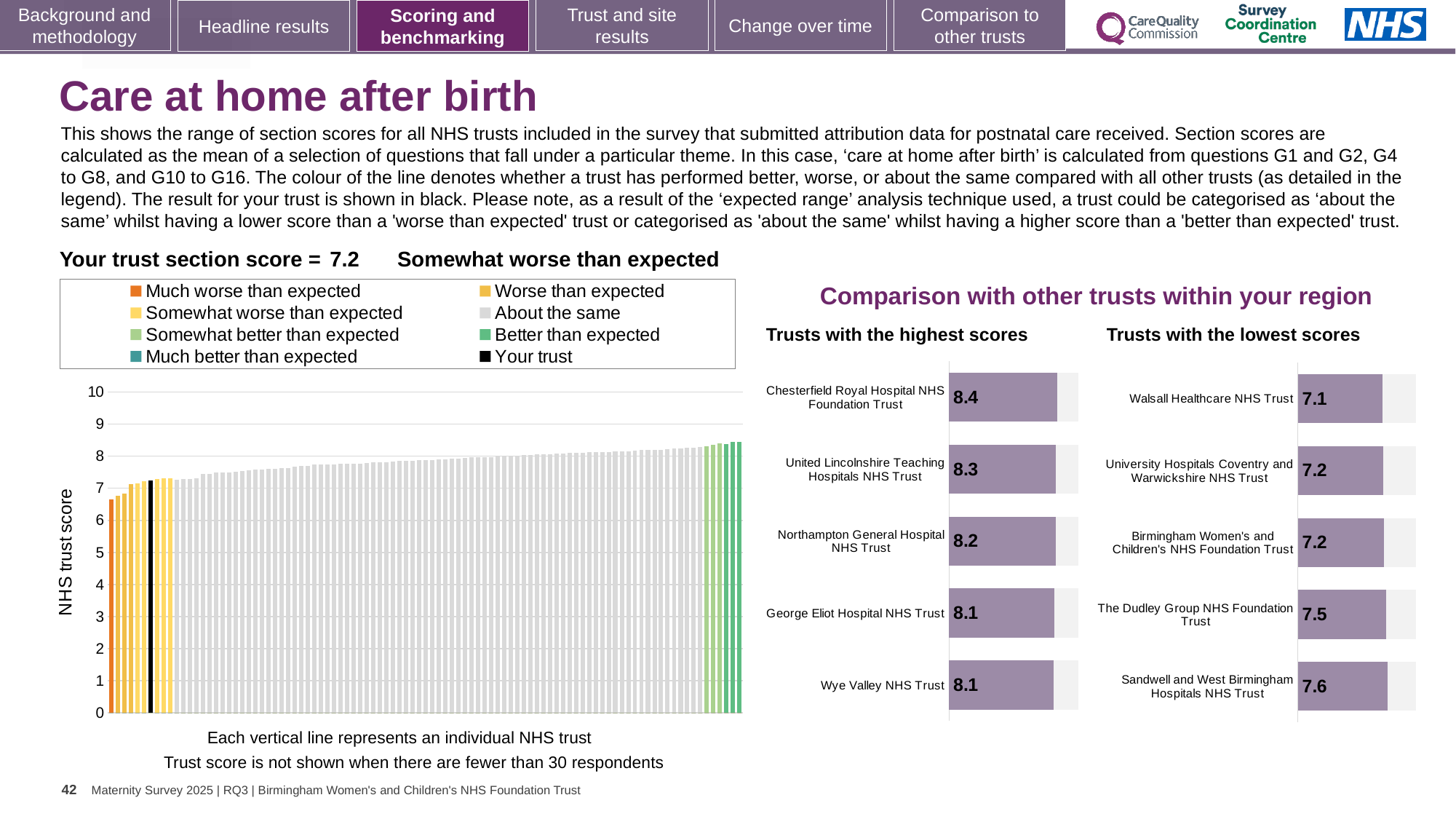
How many trusts are listed in the 'Trusts with the highest scores' chart? 5 In the main 'NHS trust score' chart on the left, is the value of the rightmost (highest) bar greater or less than 8? greater How many entries does the legend of the main 'NHS trust score' chart list? 8 In the 'Trusts with the lowest scores' chart, which trust has the lowest score? Walsall Healthcare NHS Trust In the main 'NHS trust score' chart on the left, what is the section score for your trust (the black bar)? 7.2 In the main 'NHS trust score' chart on the left, do the bar values rise or fall from left to right? rise In the 'Trusts with the highest scores' chart, what is the score for Chesterfield Royal Hospital NHS Foundation Trust? 8.4 In the 'Trusts with the lowest scores' chart, what is the difference between the scores of Sandwell and West Birmingham Hospitals NHS Trust and Walsall Healthcare NHS Trust? 0.5 In the 'Trusts with the lowest scores' chart, what is the score for The Dudley Group NHS Foundation Trust? 7.5 In the 'Trusts with the highest scores' chart, which trust has the highest score? Chesterfield Royal Hospital NHS Foundation Trust In the 'Trusts with the lowest scores' chart, which has the larger score: The Dudley Group NHS Foundation Trust or University Hospitals Coventry and Warwickshire NHS Trust? The Dudley Group NHS Foundation Trust In the 'Trusts with the highest scores' chart, what is the difference between the scores of Chesterfield Royal Hospital NHS Foundation Trust and Wye Valley NHS Trust? 0.3